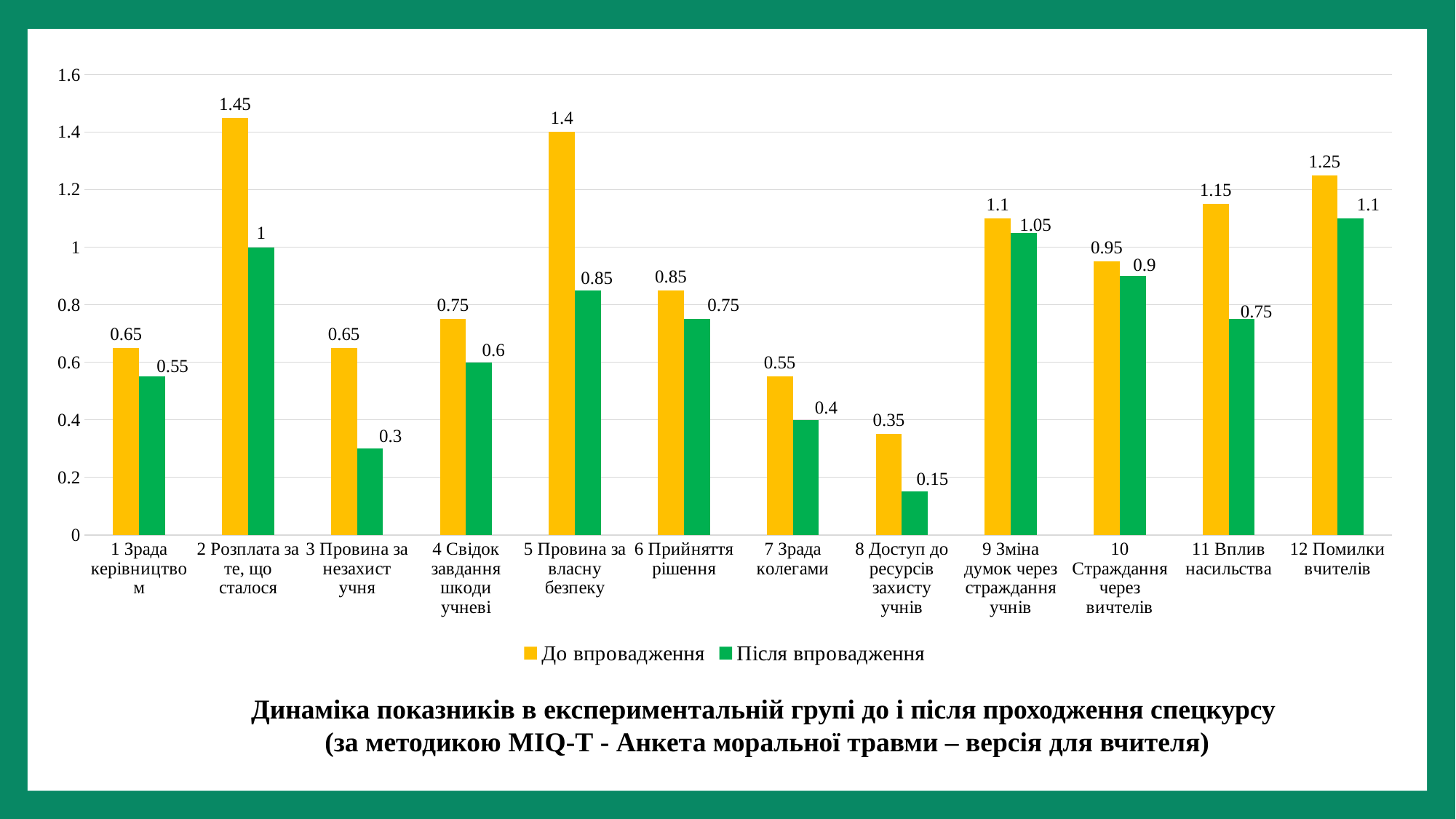
What is the value for "До впровадження" in category "2 Розплата за те, що сталося"? 1.45 Which is larger for "11 Вплив насильства": the "До впровадження" value or the "Після впровадження" value? До впровадження Which series is shown in green in the legend? Після впровадження Is the "Після впровадження" value for "12 Помилки вчителів" greater or less than 1? greater What is the value for "Після впровадження" in category "8 Доступ до ресурсів захисту учнів"? 0.15 Which category has the lowest "Після впровадження" value? 8 Доступ до ресурсів захисту учнів What type of chart is shown on the slide? bar chart Which category has the highest "До впровадження" value? 2 Розплата за те, що сталося What is the "Після впровадження" value for "9 Зміна думок через страждання учнів"? 1.05 How many series does the legend list? 2 What is the difference between the "До впровадження" and "Після впровадження" values for "5 Провина за власну безпеку"? 0.55 How many categories are shown on the x axis? 12